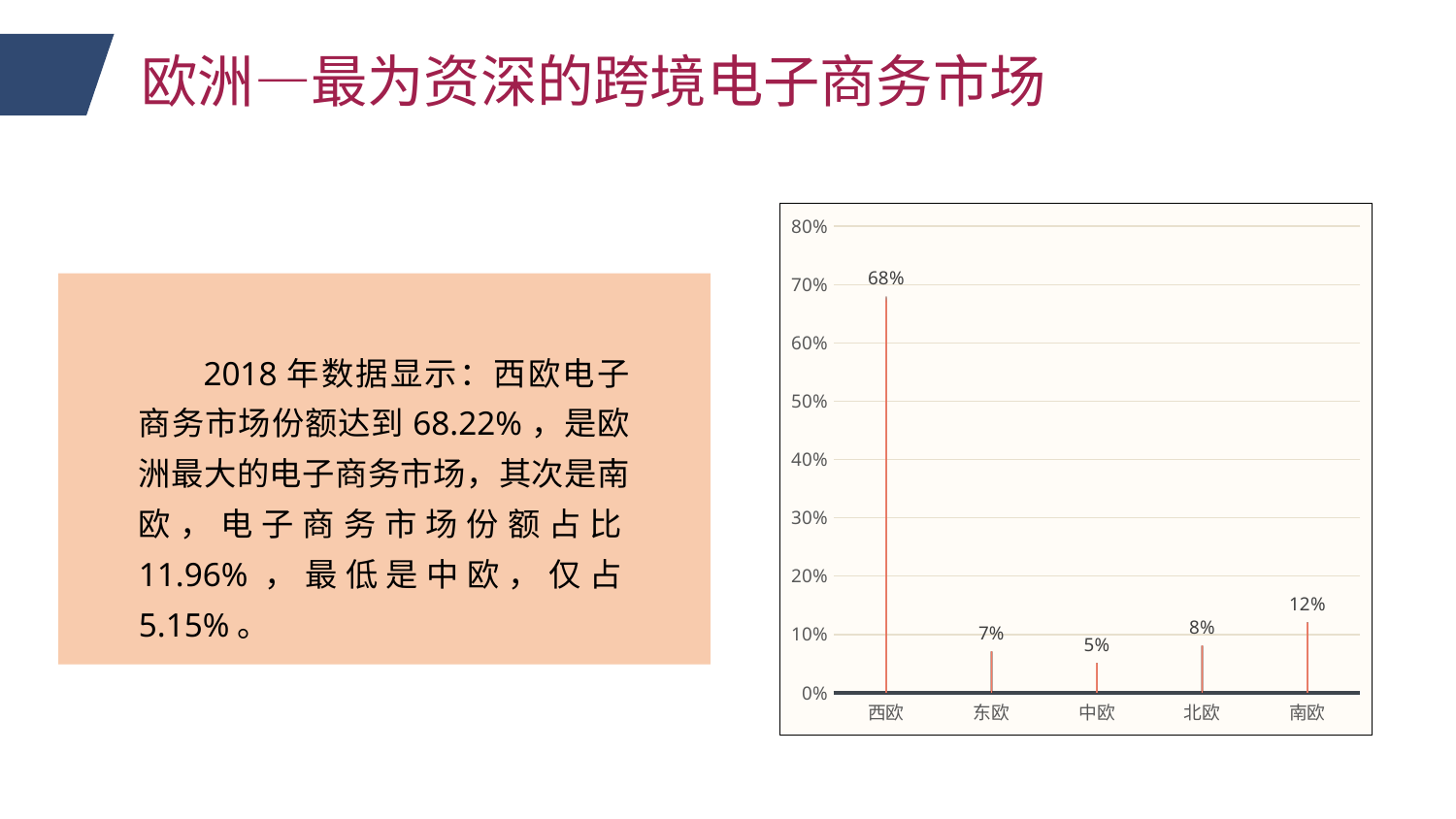
What is the value for 南欧 in the chart? 12% What is the value for 中欧 in the chart? 5% How many regions are shown on the x axis of the chart? 5 What is the difference between the values for 西欧 and 南欧? 56% What is the value for 北欧 in the chart? 8% What is the difference between the values for 北欧 and 东欧? 1% Which is larger, the value for 南欧 or the value for 东欧? 南欧 What kind of chart is shown on the slide? bar chart Is the value for 西欧 greater or less than 60%? greater Which region has the highest value in the chart? 西欧 What is the value for 西欧 in the chart? 68% Which region has the lowest value in the chart? 中欧